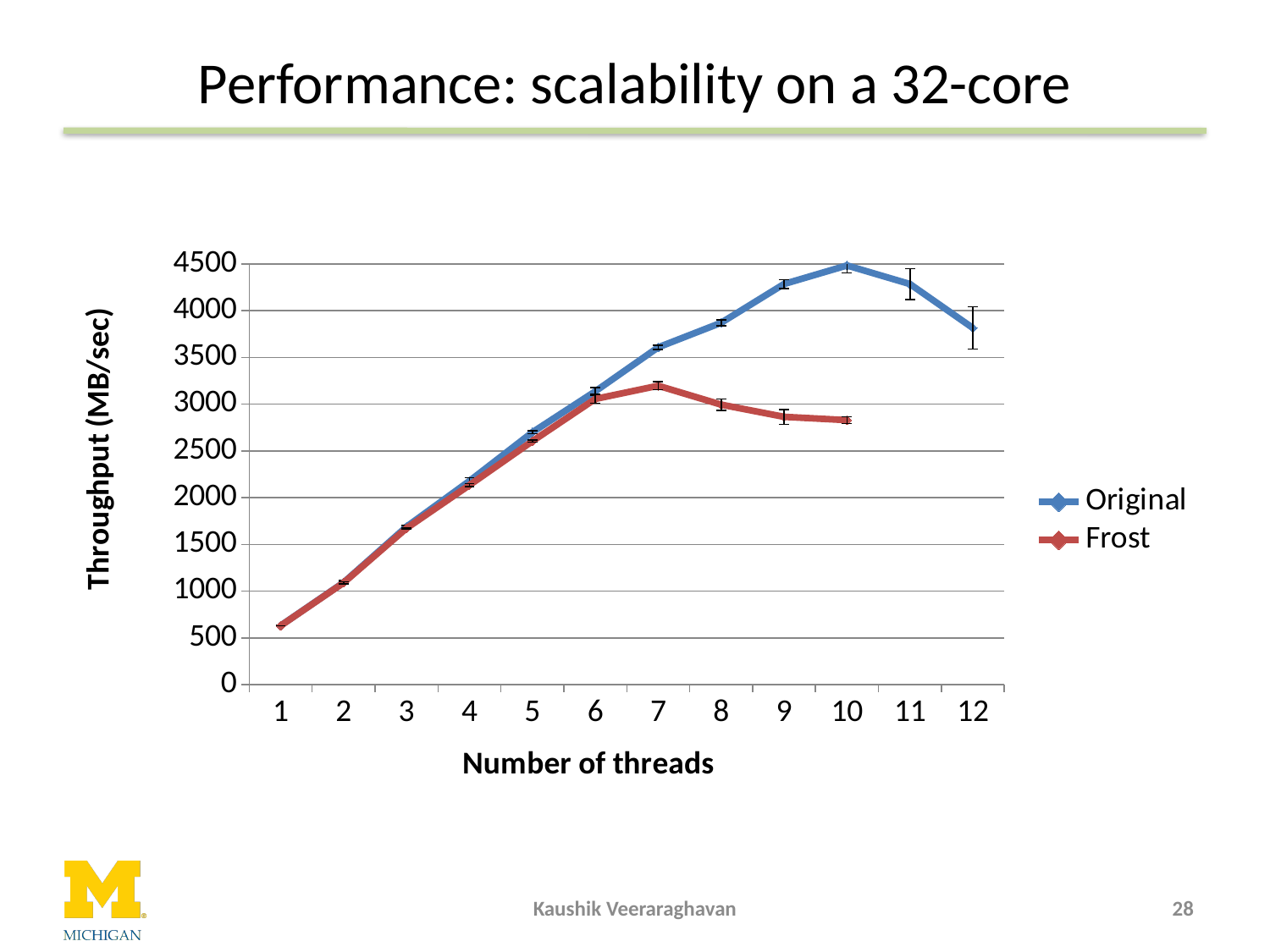
At which number of threads does the Frost series reach its highest throughput? 7 What are the names of the two series in the legend? Original and Frost At 9 threads, which series has the higher throughput, Original or Frost? Original Does the Frost series rise or fall between 7 and 10 threads? fall Is the throughput of Original at 10 threads greater or less than 4000? greater Is the throughput of Original at 12 threads greater or less than 4000? less How many thread counts are shown on the x axis? 12 What kind of chart is shown on the slide? line chart What is the label of the y axis? Throughput (MB/sec) At which number of threads does the Original series reach its highest throughput? 10 How many series does the legend list? 2 Is the throughput of Frost at 10 threads greater or less than 3000? less